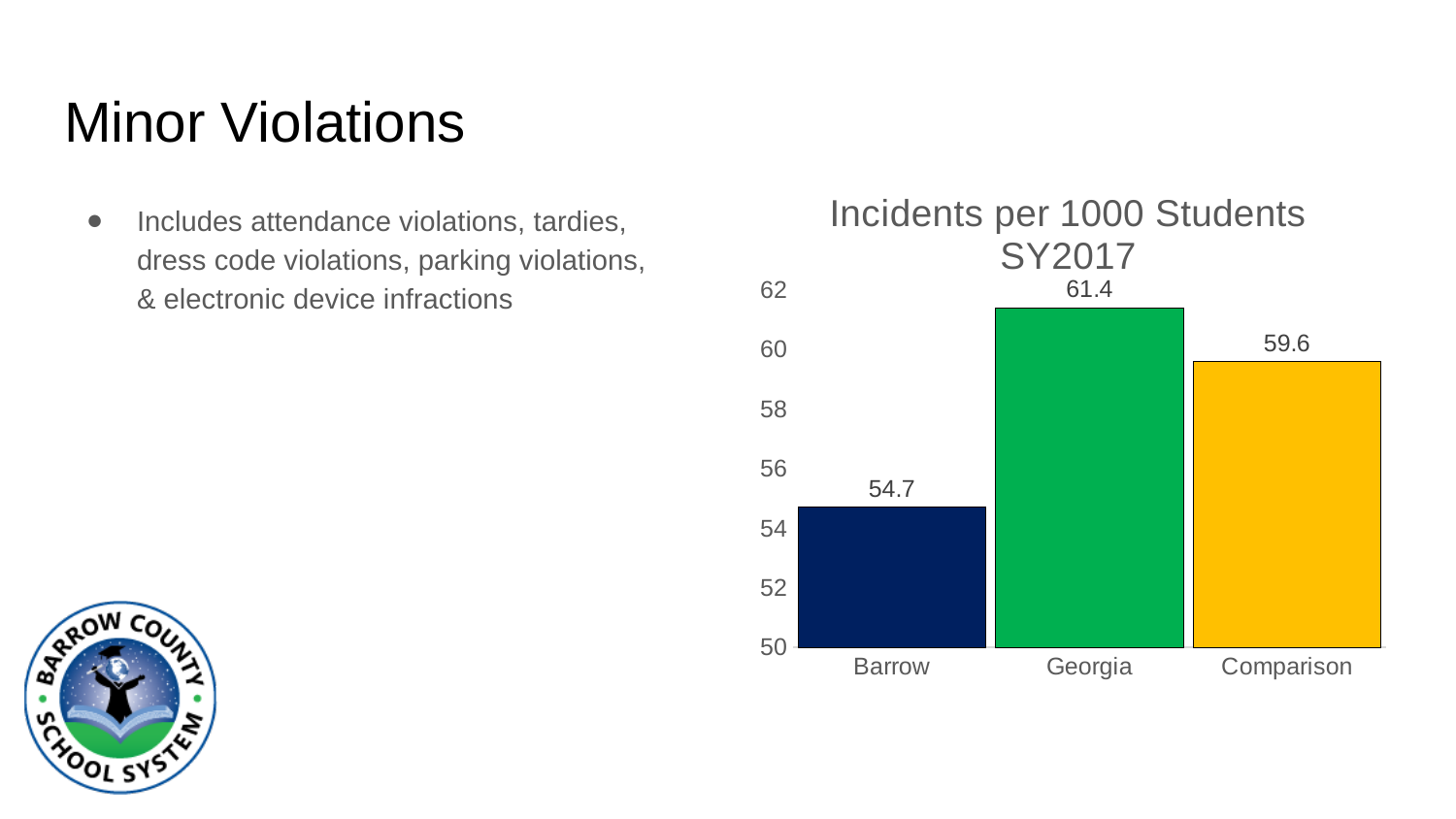
Which category has the lowest incidents per 1000 students? Barrow Which category has the highest incidents per 1000 students? Georgia What is the title of the chart? Incidents per 1000 Students SY2017 What is the difference between the Georgia and Barrow values? 6.7 What is the difference between the Comparison and Barrow values? 4.9 How many categories are shown in the chart? 3 What is the value for Georgia in the chart? 61.4 What kind of chart is shown on the slide? Bar chart What is the value for Barrow in the Incidents per 1000 Students SY2017 chart? 54.7 Which is larger, the value for Georgia or the value for Comparison? Georgia What is the value for Comparison in the chart? 59.6 Is the value for Barrow greater or less than 56? less